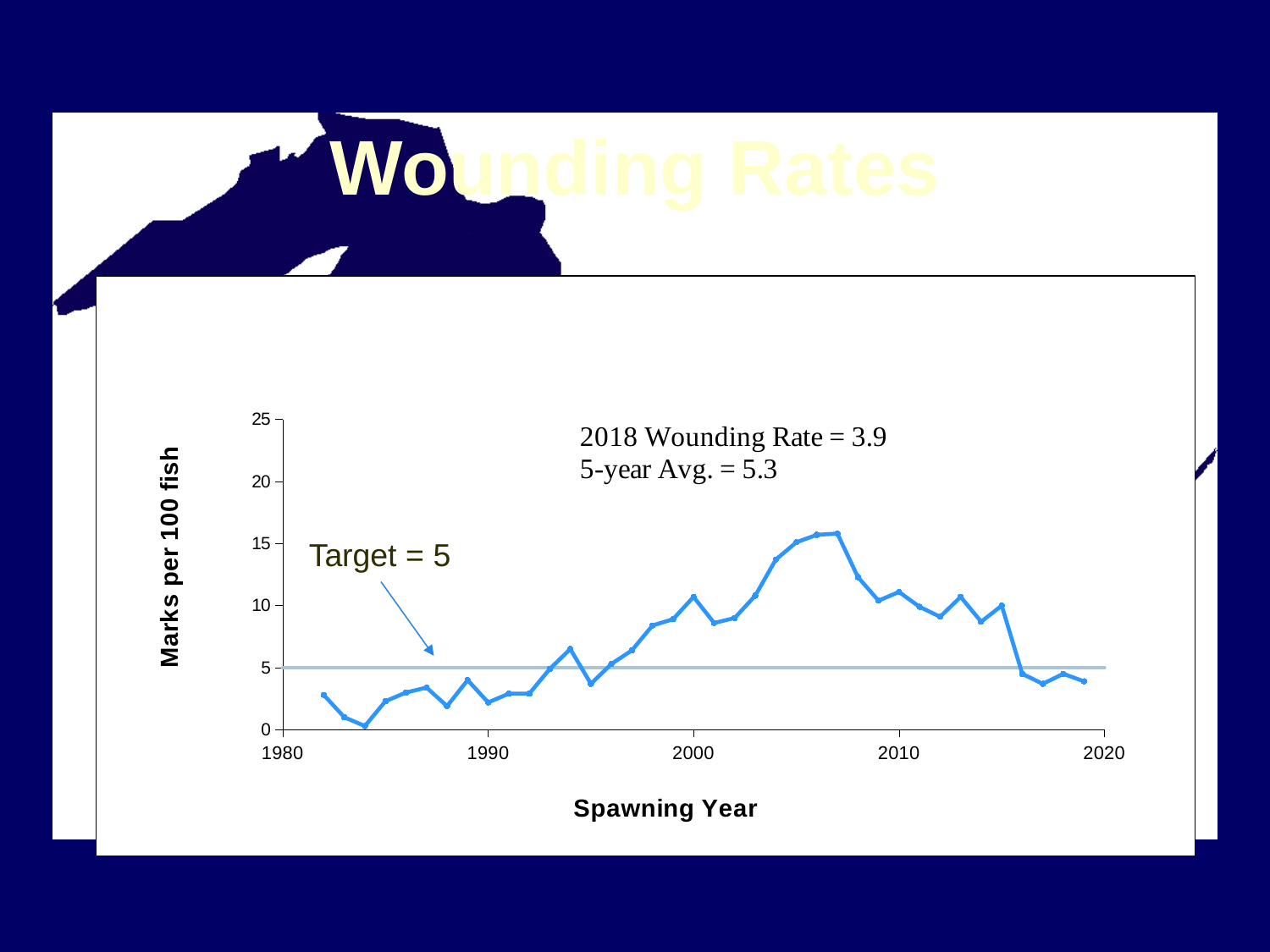
Is the wounding rate for 2008 greater or less than 10? greater What is the label on the vertical axis of the chart? Marks per 100 fish What is the 5-year average stated on the chart? 5.3 Is the wounding rate for 1984 greater or less than 5? less Which year has the higher wounding rate, 1990 or 2006? 2006 What is the label on the horizontal axis of the chart? Spawning Year What is the 2018 wounding rate stated on the chart? 3.9 What target value is marked by the horizontal line on the chart? 5 Is the wounding rate for 2006 greater or less than 15? greater What kind of chart is shown on the slide? line chart Do the wounding rates generally rise or fall between 2007 and 2017? fall